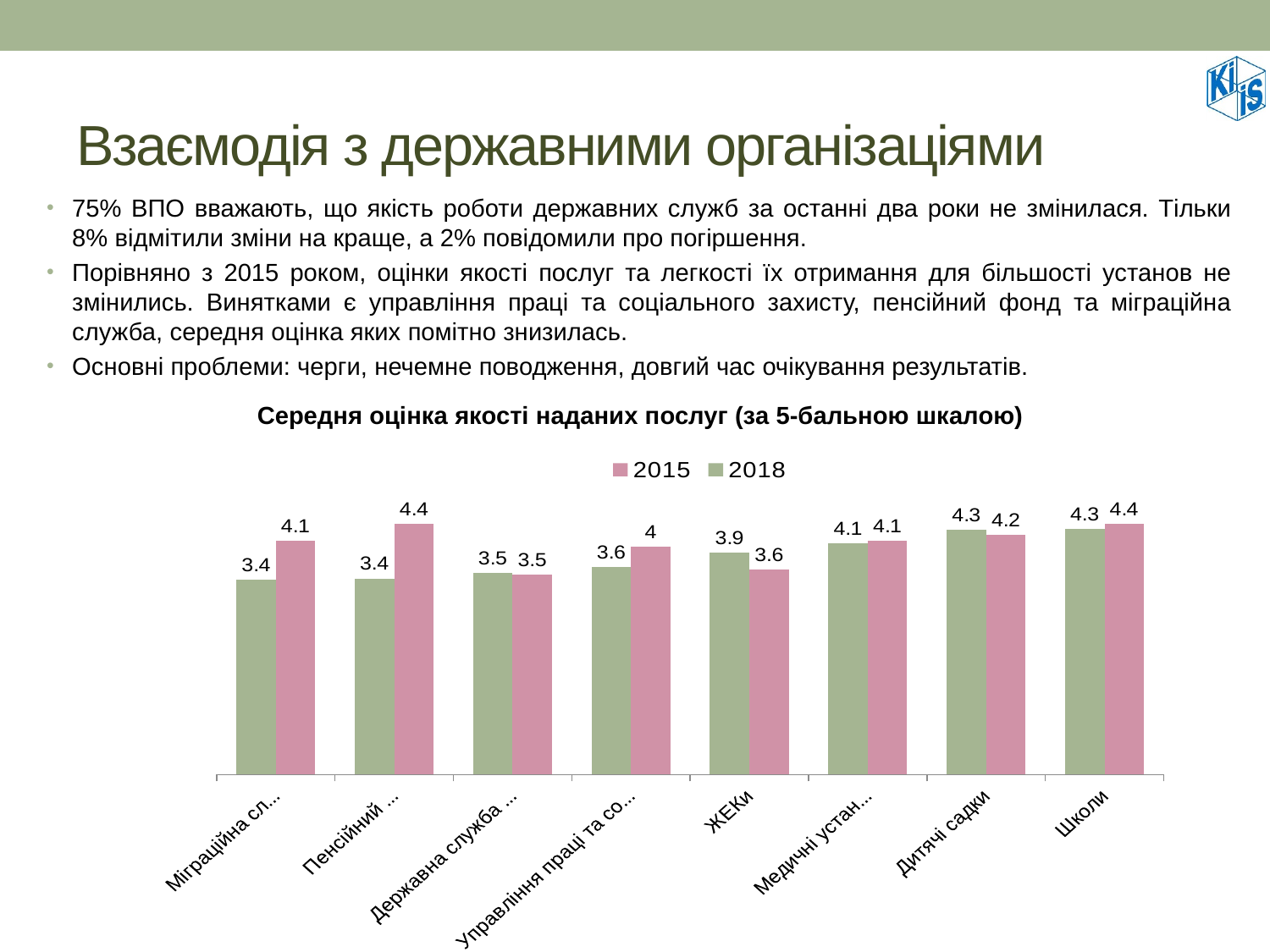
What is the highest value shown for the 2018 series? 4.3 What is the 2018 value for Дитячі садки? 4.3 What kind of chart is shown on the slide? Bar chart What is the difference between the 2018 and 2015 values for ЖЕКи? 0.3 What is the 2015 value for ЖЕКи? 3.6 What is the 2015 value for Школи? 4.4 For Школи, which year has the higher value, 2015 or 2018? 2015 What is the 2018 value for ЖЕКи? 3.9 How many series does the legend list? 2 How many categories are shown on the x axis of the chart? 8 For Дитячі садки, which year has the higher value, 2015 or 2018? 2018 What is the title of the chart? Середня оцінка якості наданих послуг (за 5-бальною шкалою)